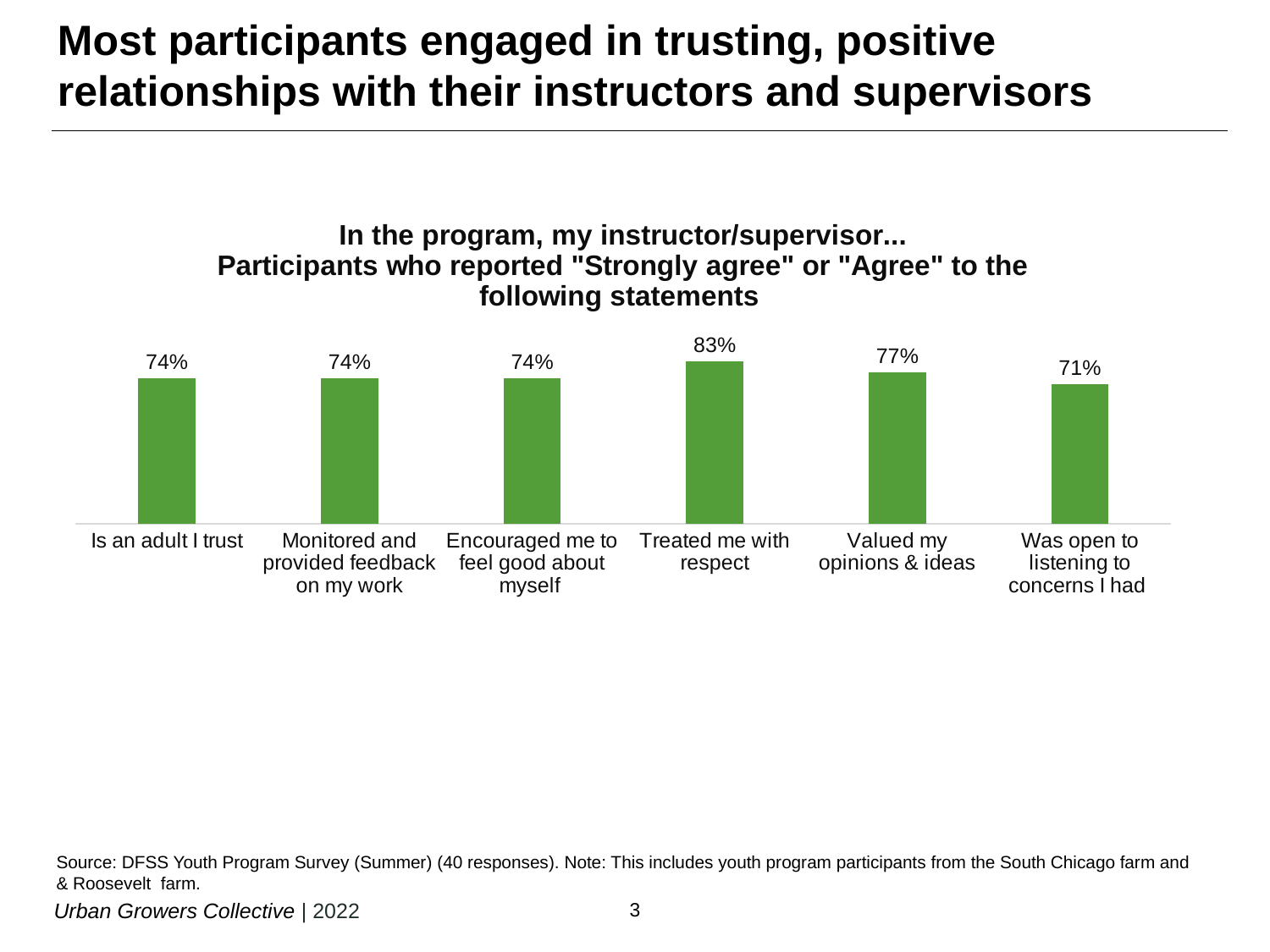
What percentage of participants agreed that their instructor/supervisor "Is an adult I trust"? 74% How many statements share the value 74%? 3 Which statement has the lowest percentage of participants agreeing? Was open to listening to concerns I had What percentage of participants agreed that their instructor/supervisor "Was open to listening to concerns I had"? 71% How many statements are shown in the chart? 6 What type of chart is shown on the slide? Bar chart What percentage of participants agreed that their instructor/supervisor "Valued my opinions & ideas"? 77% What percentage of participants agreed that their instructor/supervisor "Treated me with respect"? 83% Which statement has the highest percentage of participants agreeing? Treated me with respect What is the difference in percentage points between "Valued my opinions & ideas" and "Is an adult I trust"? 3 percentage points What is the difference in percentage points between "Treated me with respect" and "Was open to listening to concerns I had"? 12 percentage points Which has a higher percentage: "Valued my opinions & ideas" or "Monitored and provided feedback on my work"? Valued my opinions & ideas